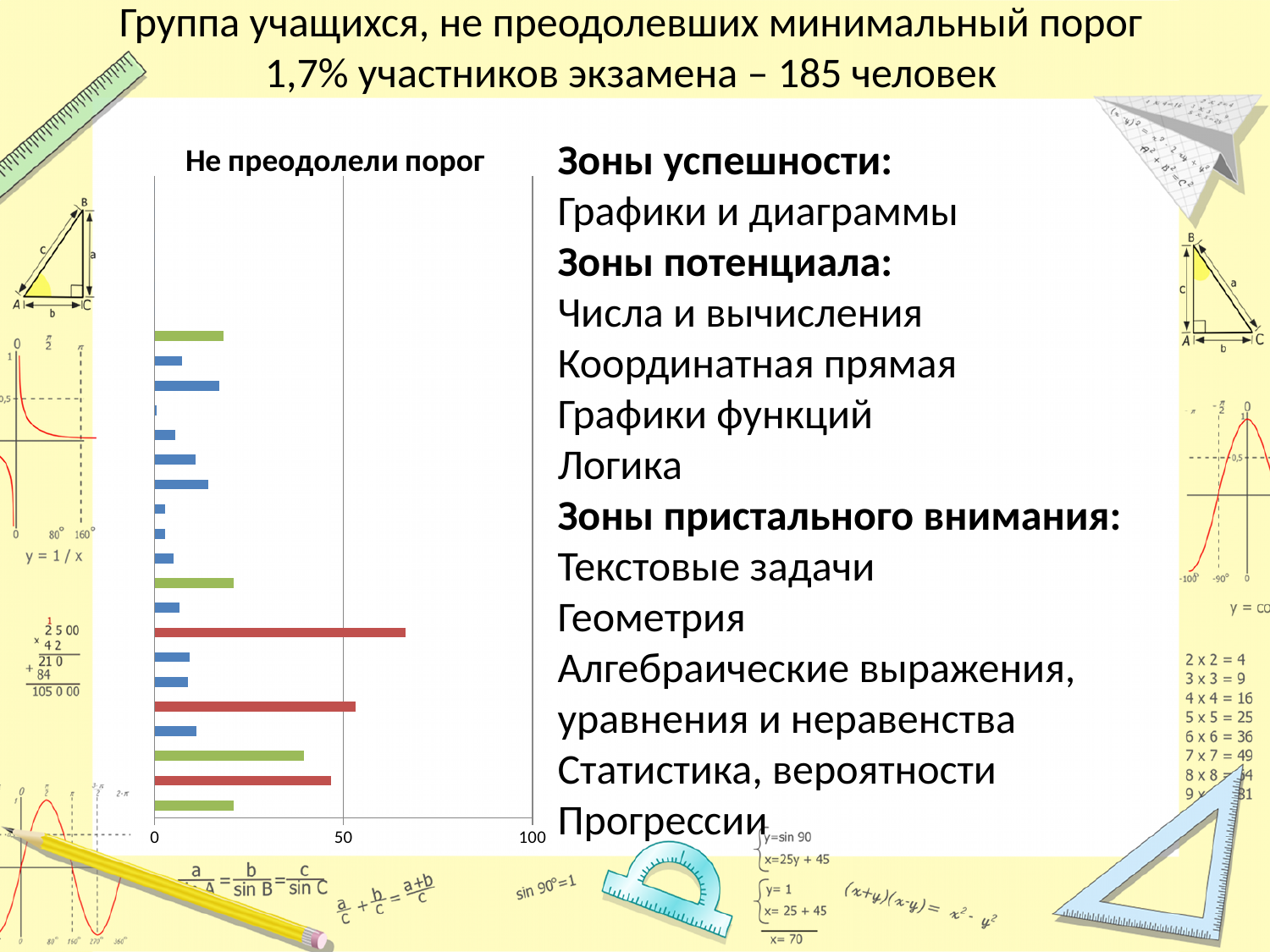
What colour is the longest bar in the chart? red What is the title of the chart? Не преодолели порог What is the highest value shown on the chart's x axis? 100 How many bars are plotted in the chart? 20 Is the value of the topmost (green) bar greater or less than 50? less What kind of chart is shown on the slide? bar chart Is the value of the longest bar in the chart greater or less than 50? greater Is the value of the longest bar in the chart greater or less than 100? less